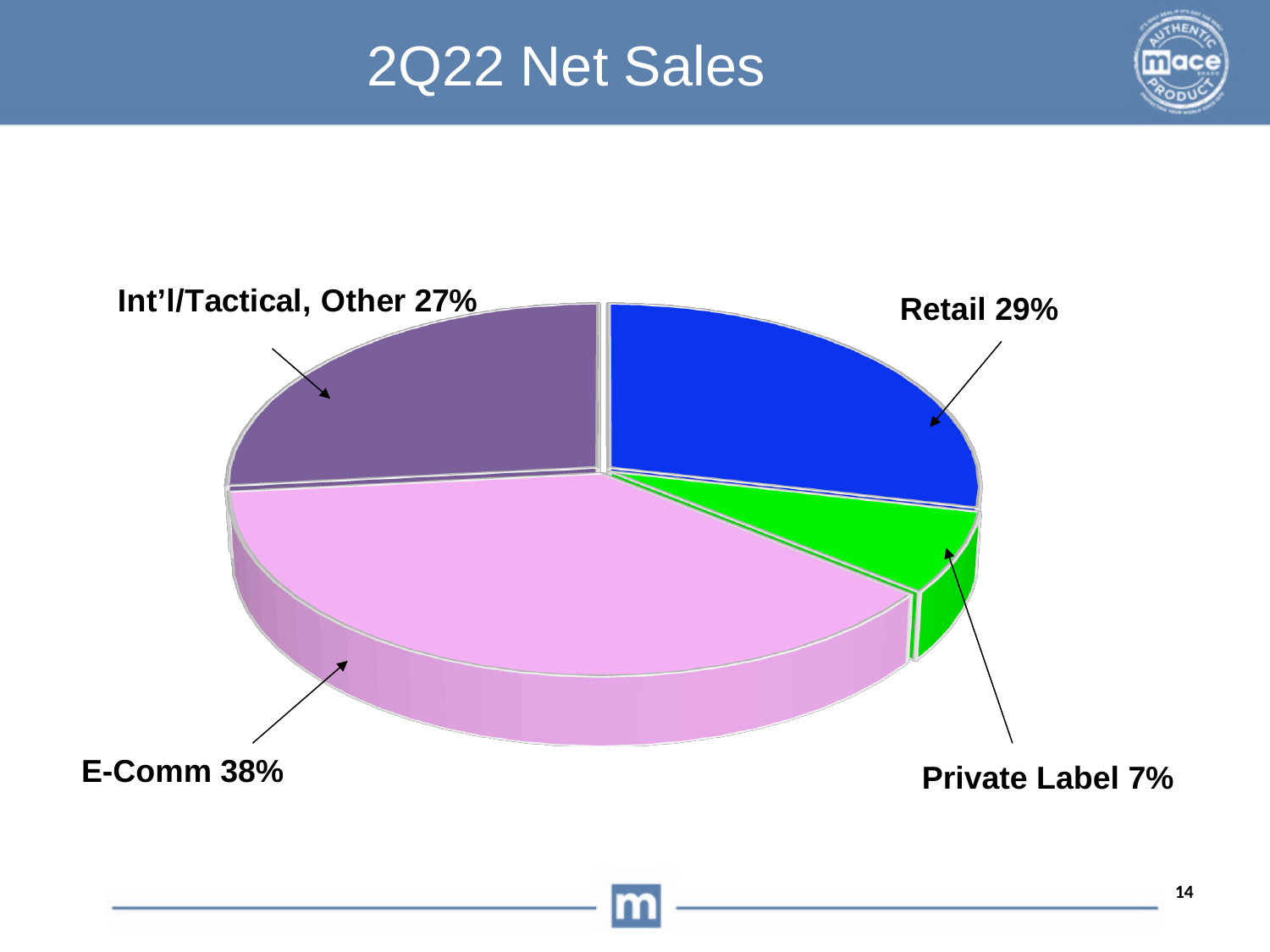
What share of 2Q22 Net Sales does Retail account for? 29% What share of 2Q22 Net Sales does E-Comm account for? 38% Which category has the largest share of 2Q22 Net Sales? E-Comm What is the title of the chart on the slide? 2Q22 Net Sales Which category has the smallest share of 2Q22 Net Sales? Private Label How many percentage points larger is the E-Comm share than the Retail share? 9 What share of 2Q22 Net Sales does Int'l/Tactical, Other account for? 27% How many categories are shown in the pie chart? 4 What kind of chart is shown on the slide? Pie chart Which is larger, the Retail share or the Int'l/Tactical, Other share? Retail What share of 2Q22 Net Sales does Private Label account for? 7% How many percentage points larger is the Retail share than the Private Label share? 22